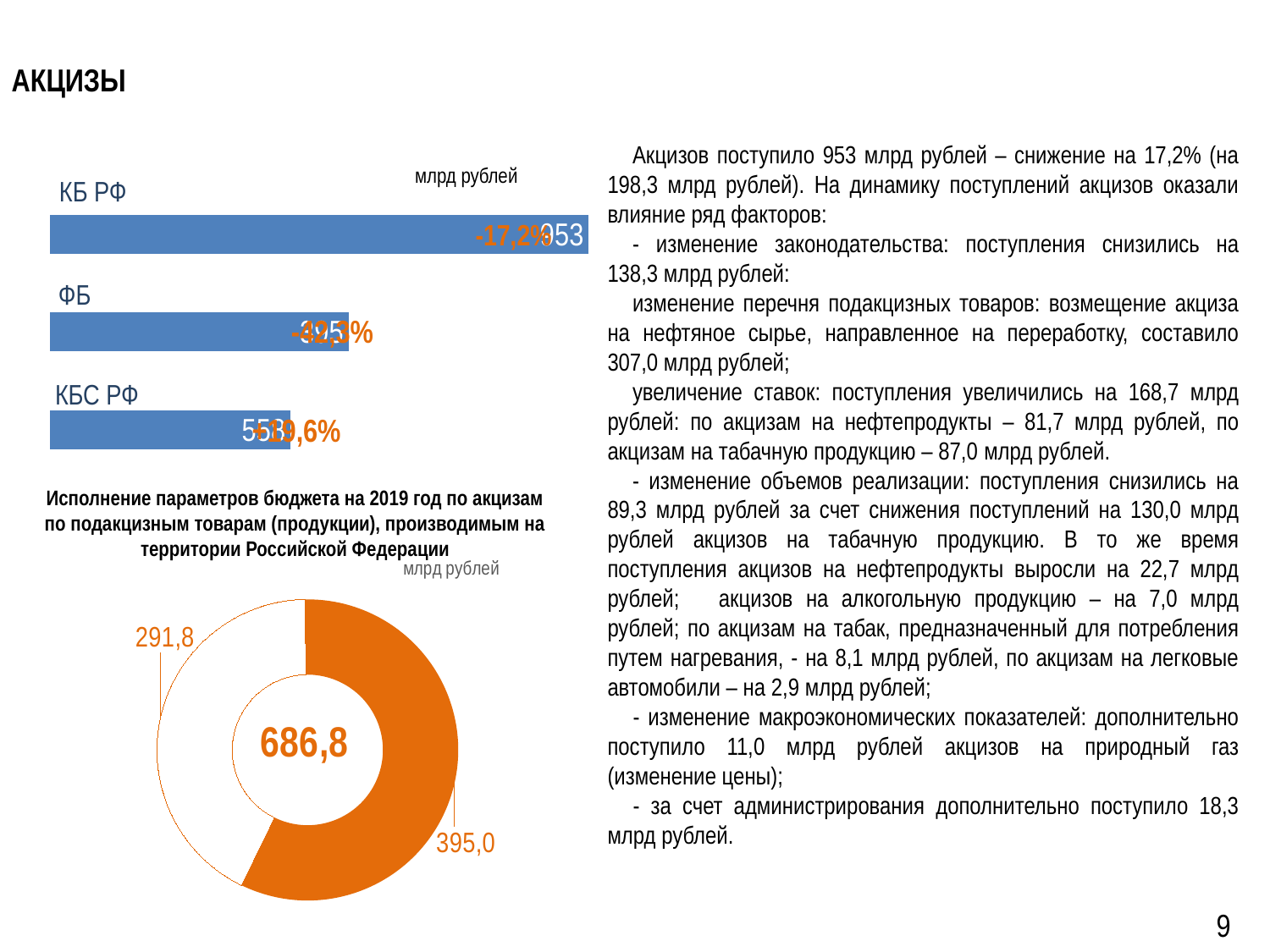
In the bar chart at the top left, what percentage change is shown for КБ РФ? -17,2% How many categories does the bar chart at the top left show? 3 In the bar chart at the top left, what value is shown for КБ РФ? 953 In the bar chart at the top left, which category has the longest bar? КБ РФ In the bar chart at the top left, what unit is stated for the values? млрд рублей In the donut chart at the bottom left, what is the difference between the two slices, 395,0 and 291,8? 103,2 In the donut chart at the bottom left, what is the value of the larger (orange) slice? 395,0 In the donut chart at the bottom left, what total value is shown in the centre? 686,8 What kind of chart is the chart at the top left with КБ РФ, ФБ and КБС РФ? bar chart How many slices does the donut chart at the bottom left have? 2 In the donut chart at the bottom left, what is the value of the smaller (white) slice? 291,8 In the bar chart at the top left, which bar is longer, КБ РФ or ФБ? КБ РФ